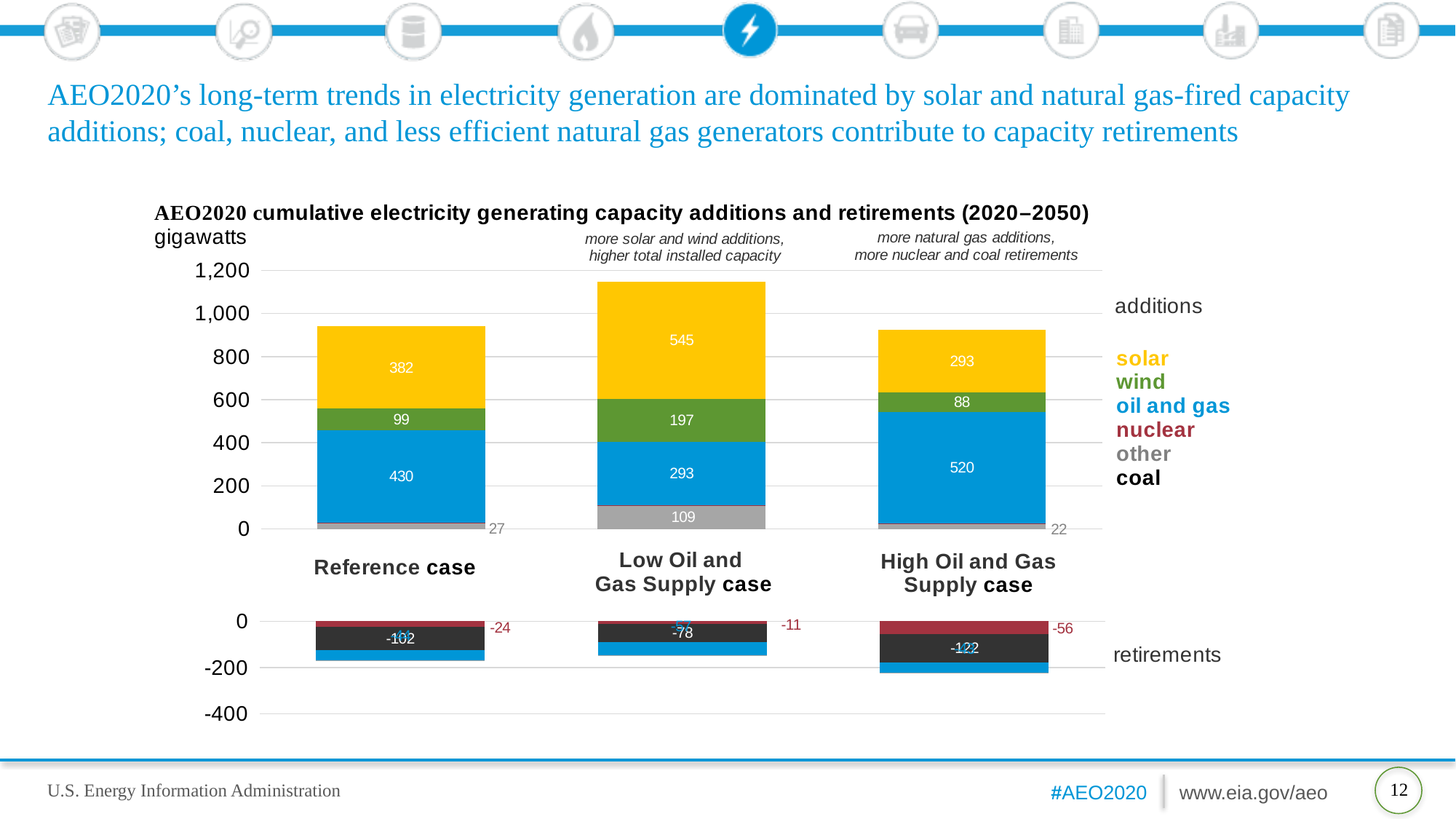
Is the total capacity addition in the Low Oil and Gas Supply case greater or less than 1,000 gigawatts? greater How much larger are solar additions in the Low Oil and Gas Supply case than in the Reference case? 163 What is the 'other' capacity addition in the Reference case? 27 What is the nuclear retirement value in the High Oil and Gas Supply case? -56 What is the oil and gas capacity addition in the High Oil and Gas Supply case? 520 Which case has the lowest wind capacity additions? High Oil and Gas Supply case What is the coal retirement value in the Reference case? -102 What is the wind capacity addition in the Reference case? 99 What is the solar capacity addition in the Low Oil and Gas Supply case? 545 Which case has larger oil and gas capacity additions, the Reference case or the Low Oil and Gas Supply case? Reference case How many series does the legend list? 6 Which case has the highest solar capacity additions? Low Oil and Gas Supply case